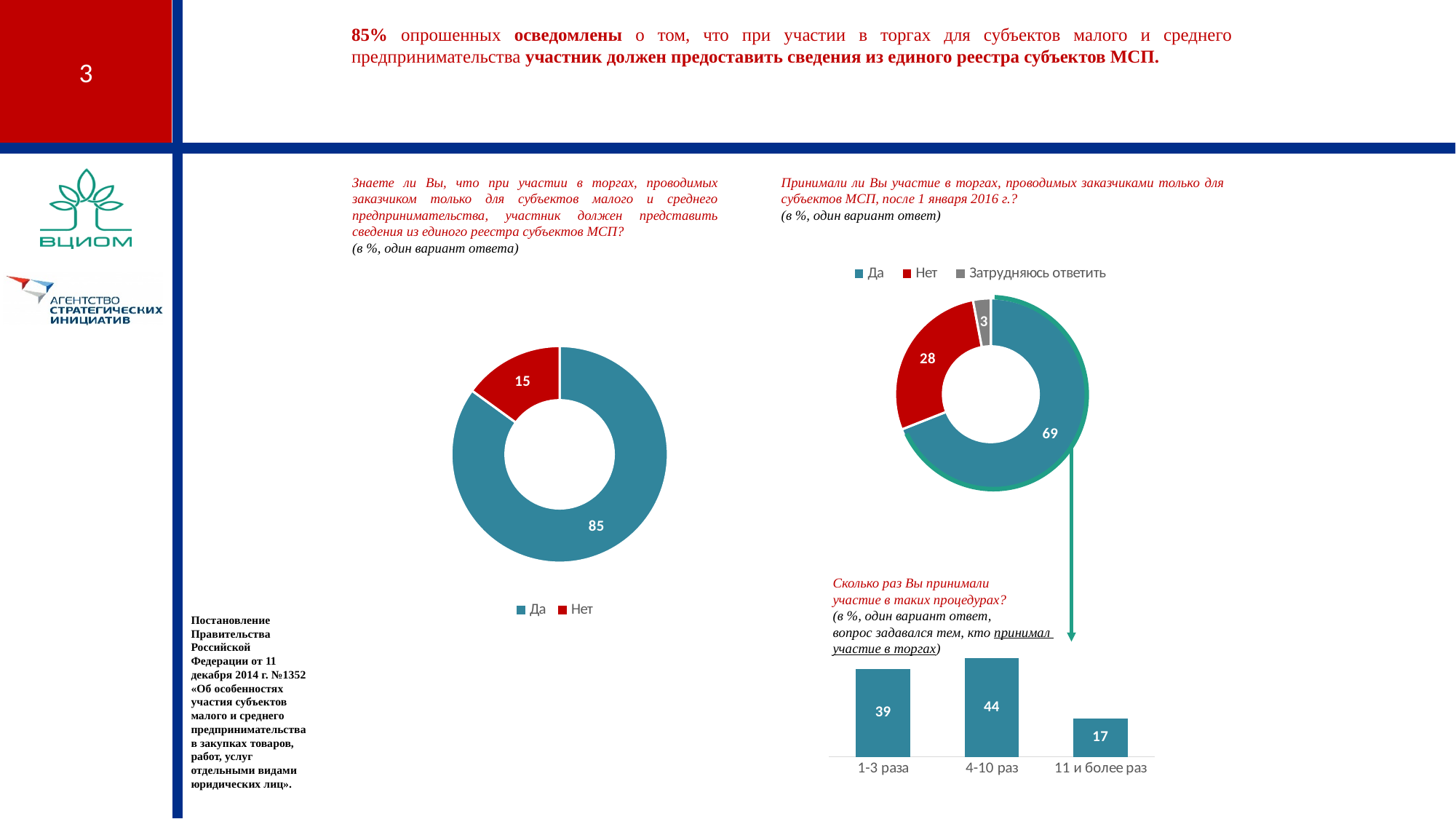
In the upper-right donut chart, what is the value for "Нет"? 28 In the left donut chart, what is the value for "Да"? 85 In the upper-right donut chart, which category has the lowest value? Затрудняюсь ответить How many series does the legend of the left donut chart list? 2 In the left donut chart, what is the value for "Нет"? 15 In the upper-right donut chart, what is the value for "Затрудняюсь ответить"? 3 In the bottom-right chart, what is the value for "4-10 раз"? 44 In the bottom-right chart, what is the difference between the values for "1-3 раза" and "11 и более раз"? 22 In the left donut chart, what is the difference between the values for "Да" and "Нет"? 70 What kind of chart is the bottom-right chart? Bar chart In the bottom-right chart, which category has the highest value? 4-10 раз How many series does the legend of the upper-right donut chart list? 3